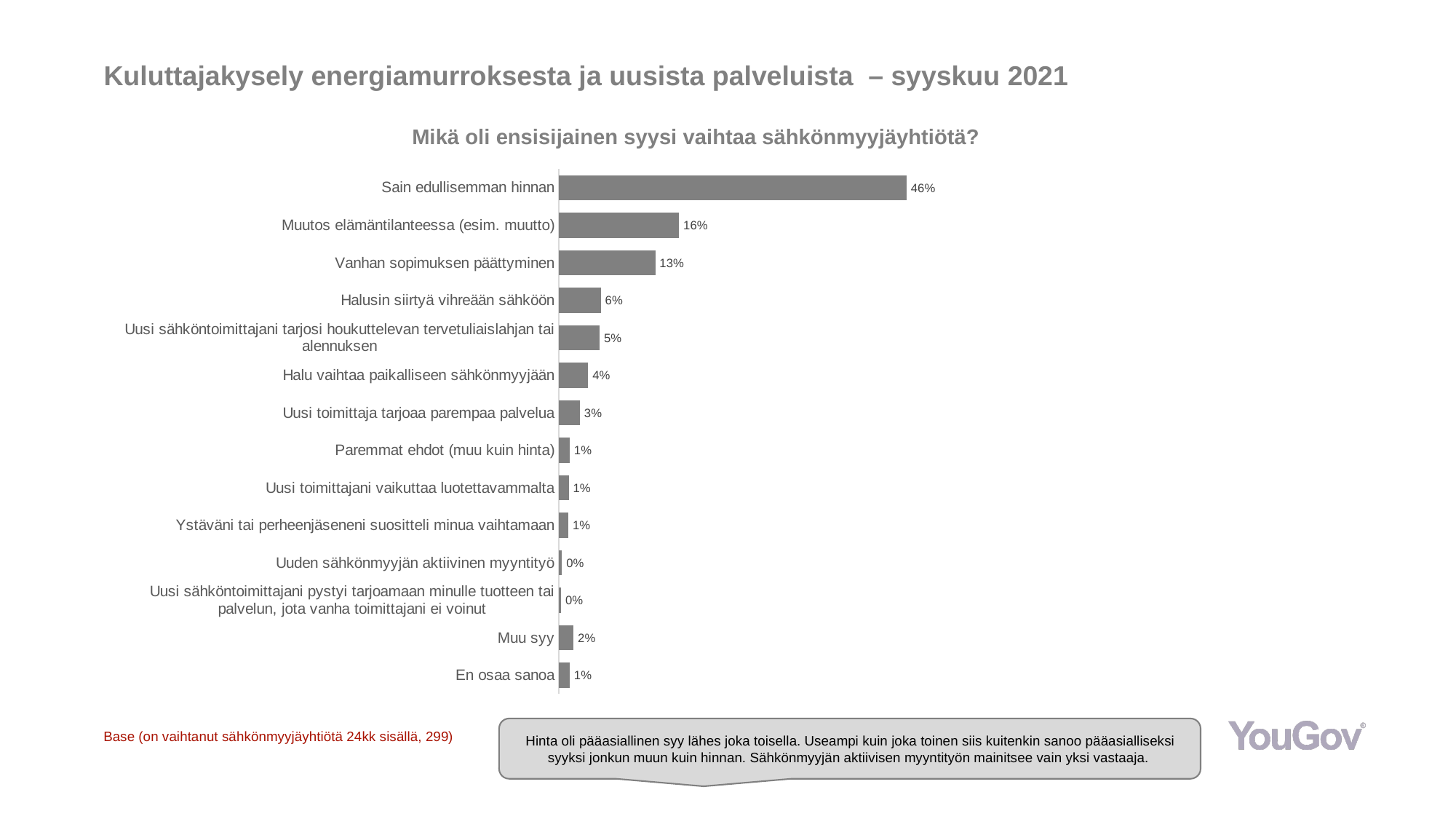
What is the title of the chart? Mikä oli ensisijainen syysi vaihtaa sähkönmyyjäyhtiötä? What is the value shown for "Muu syy"? 2% What is the value shown for "Vanhan sopimuksen päättyminen"? 13% Which has a larger value: "Halu vaihtaa paikalliseen sähkönmyyjään" or "Uusi toimittaja tarjoaa parempaa palvelua"? Halu vaihtaa paikalliseen sähkönmyyjään How many categories are shown in the chart? 14 What is the difference between the values for "Muutos elämäntilanteessa (esim. muutto)" and "Vanhan sopimuksen päättyminen"? 3% What is the value shown for "Halusin siirtyä vihreään sähköön"? 6% How many categories in the chart show a value of 0%? 2 Which category has the highest value in the chart? Sain edullisemman hinnan What percentage of respondents chose "Sain edullisemman hinnan" as their primary reason? 46% What kind of chart is shown on the slide? Bar chart What is the difference between the values for "Sain edullisemman hinnan" and "Muutos elämäntilanteessa (esim. muutto)"? 30%